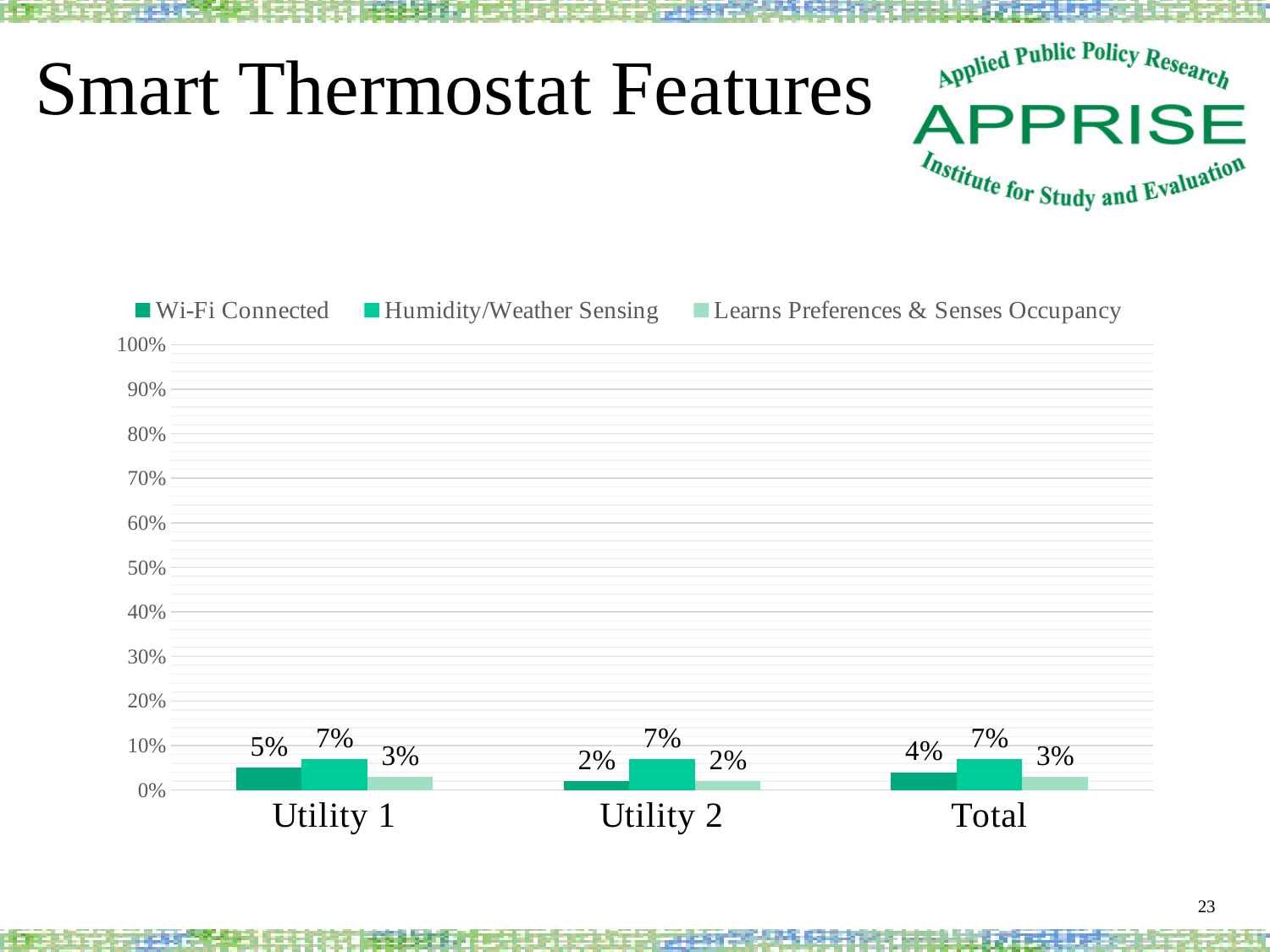
What is the value for Wi-Fi Connected for Utility 1? 5% What is the difference between Humidity/Weather Sensing and Wi-Fi Connected for Utility 2? 5% Which category has the highest value for Wi-Fi Connected? Utility 1 What is the value for Wi-Fi Connected for Utility 2? 2% Which category has the lowest value for Learns Preferences & Senses Occupancy? Utility 2 How many series does the legend list? 3 How many categories are shown on the x axis? 3 What is the value for Humidity/Weather Sensing for Utility 2? 7% What is the value for Learns Preferences & Senses Occupancy for Total? 3% What kind of chart is shown on the slide? bar chart Which is larger for Total: Wi-Fi Connected or Humidity/Weather Sensing? Humidity/Weather Sensing Is the value for Humidity/Weather Sensing for Utility 1 greater or less than 10%? less